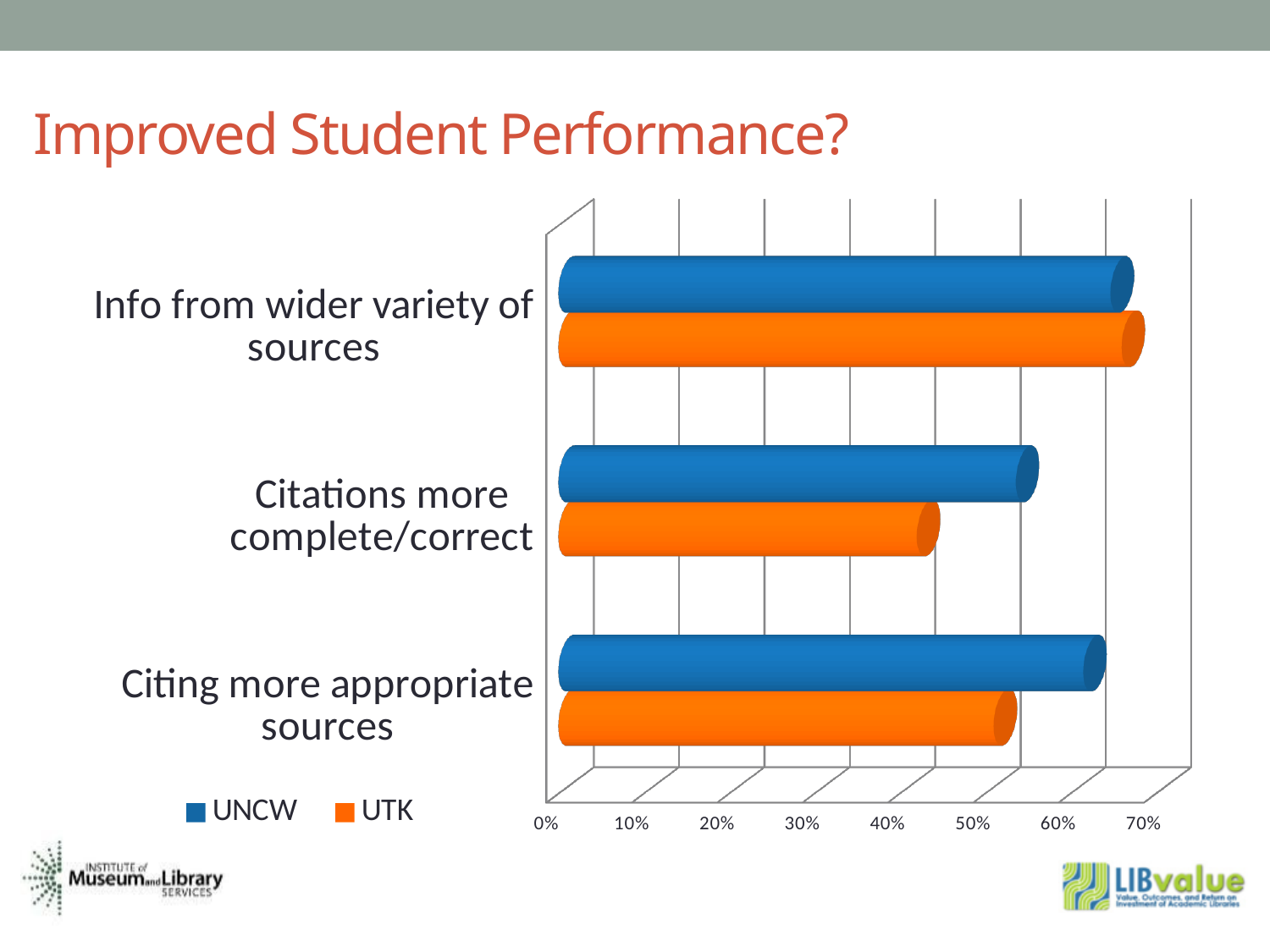
What are the two series named in the legend? UNCW and UTK For 'Citations more complete/correct', which series has the larger value, UNCW or UTK? UNCW What kind of chart is shown on the slide? Bar chart How many series does the legend list? 2 How many categories are plotted on the chart? 3 Is the UNCW value for 'Info from wider variety of sources' greater or less than 60%? greater Is the UTK value for 'Citations more complete/correct' greater or less than 50%? less Which category has the highest UTK value? Info from wider variety of sources Is the UTK value for 'Citing more appropriate sources' greater or less than 40%? greater Which category has the lowest UNCW value? Citations more complete/correct What is the title of the slide containing the chart? Improved Student Performance? For 'Citing more appropriate sources', which series has the larger value, UNCW or UTK? UNCW